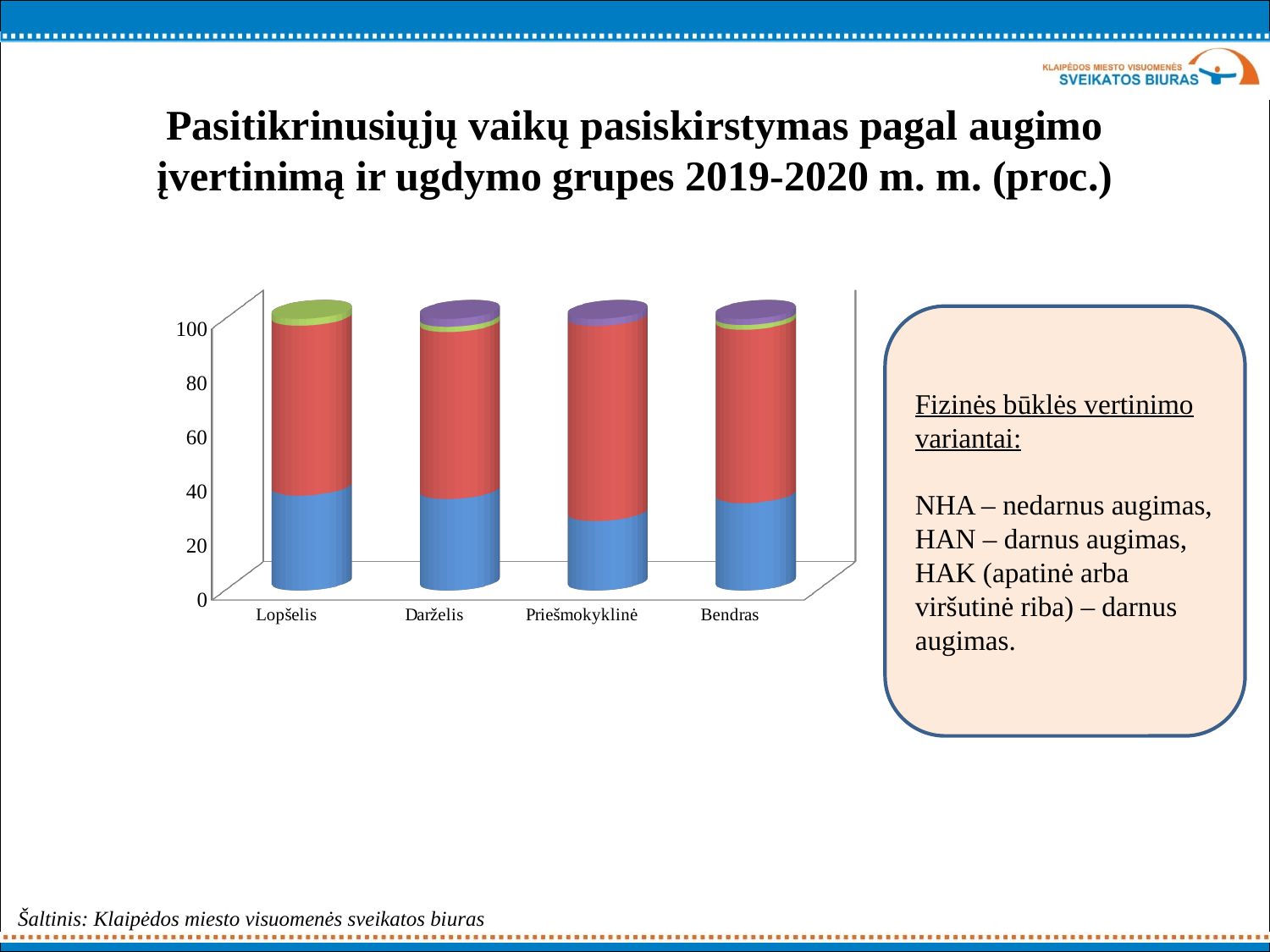
Which has the larger blue (bottom) segment, Lopšelis or Priešmokyklinė? Lopšelis Is the blue (bottom) segment for Lopšelis greater or less than 20? greater What is the highest value shown on the y axis of the chart? 100 Which category is listed first on the x axis of the chart? Lopšelis Is the blue (bottom) segment for Bendras greater or less than 20? greater Is the blue (bottom) segment for Darželis greater or less than 60? less Which category has the smallest blue (bottom) segment? Priešmokyklinė Which has the larger blue (bottom) segment, Bendras or Priešmokyklinė? Bendras What kind of chart is shown on the slide? bar chart What is the title of the chart on the slide? Pasitikrinusiųjų vaikų pasiskirstymas pagal augimo įvertinimą ir ugdymo grupes 2019-2020 m. m. (proc.) How many categories are shown on the x axis of the chart? 4